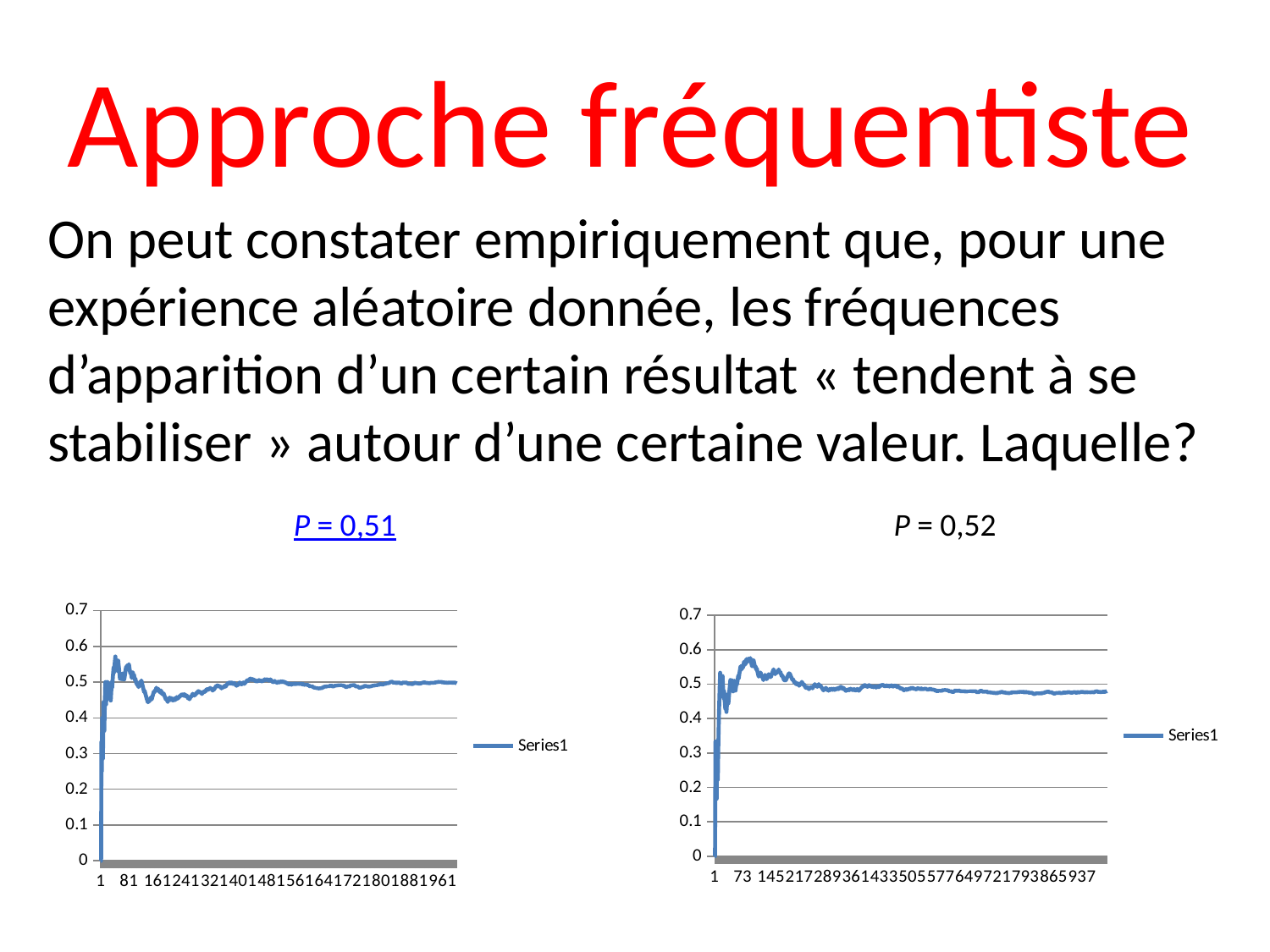
In the left chart (P = 0,51), is the value at the right end of the line greater or less than 0.6? less In the right chart (P = 0,52), is the value at the right end of the line greater or less than 0.3? greater In the left chart (P = 0,51), is the value at the right end of the line greater or less than 0.4? greater What is the highest value shown on the vertical axis of the right chart (P = 0,52)? 0.7 How many charts are shown on the slide? 2 How many series does the legend of the left chart (P = 0,51) list? 1 What is the name of the series shown in the legend of the right chart (P = 0,52)? Series1 What kind of chart is the chart labelled P = 0,52 on the right? line chart What kind of chart is the chart labelled P = 0,51 on the left? line chart